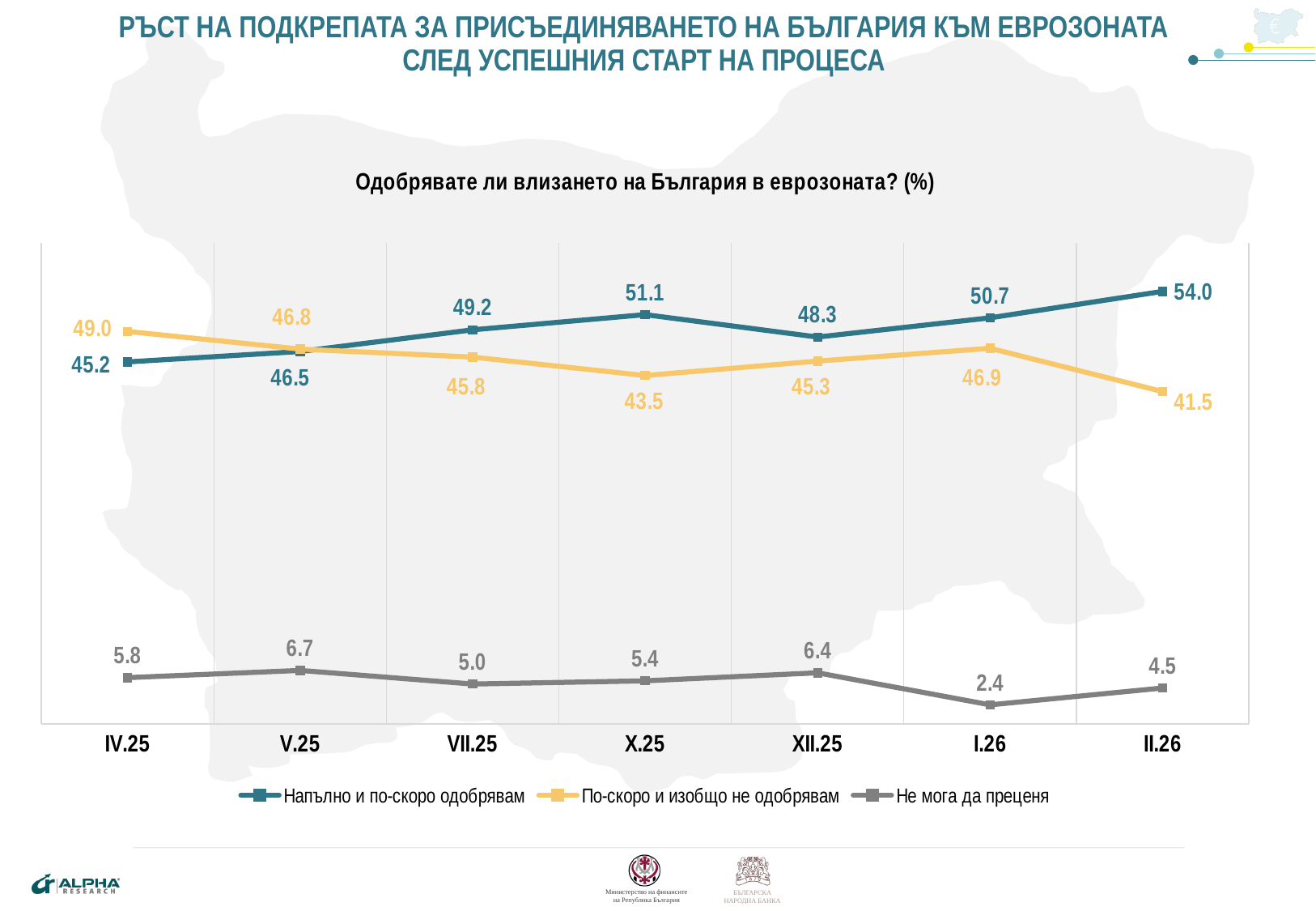
How many series does the legend list? 3 What type of chart is shown on the slide? Line chart Does the "Напълно и по-скоро одобрявам" series rise or fall between XII.25 and II.26? Rise At which time point is the "По-скоро и изобщо не одобрявам" series lowest? II.26 At IV.25, which is larger: "Напълно и по-скоро одобрявам" or "По-скоро и изобщо не одобрявам"? По-скоро и изобщо не одобрявам What is the value for "Напълно и по-скоро одобрявам" at II.26? 54.0 How many time points are shown on the x axis? 7 What is the value for "По-скоро и изобщо не одобрявам" at IV.25? 49.0 At which time point is the "Напълно и по-скоро одобрявам" series highest? II.26 What is the value for "Не мога да преценя" at I.26? 2.4 What is the title of the chart? Одобрявате ли влизането на България в еврозоната? (%) What is the difference between "Напълно и по-скоро одобрявам" and "По-скоро и изобщо не одобрявам" at II.26? 12.5